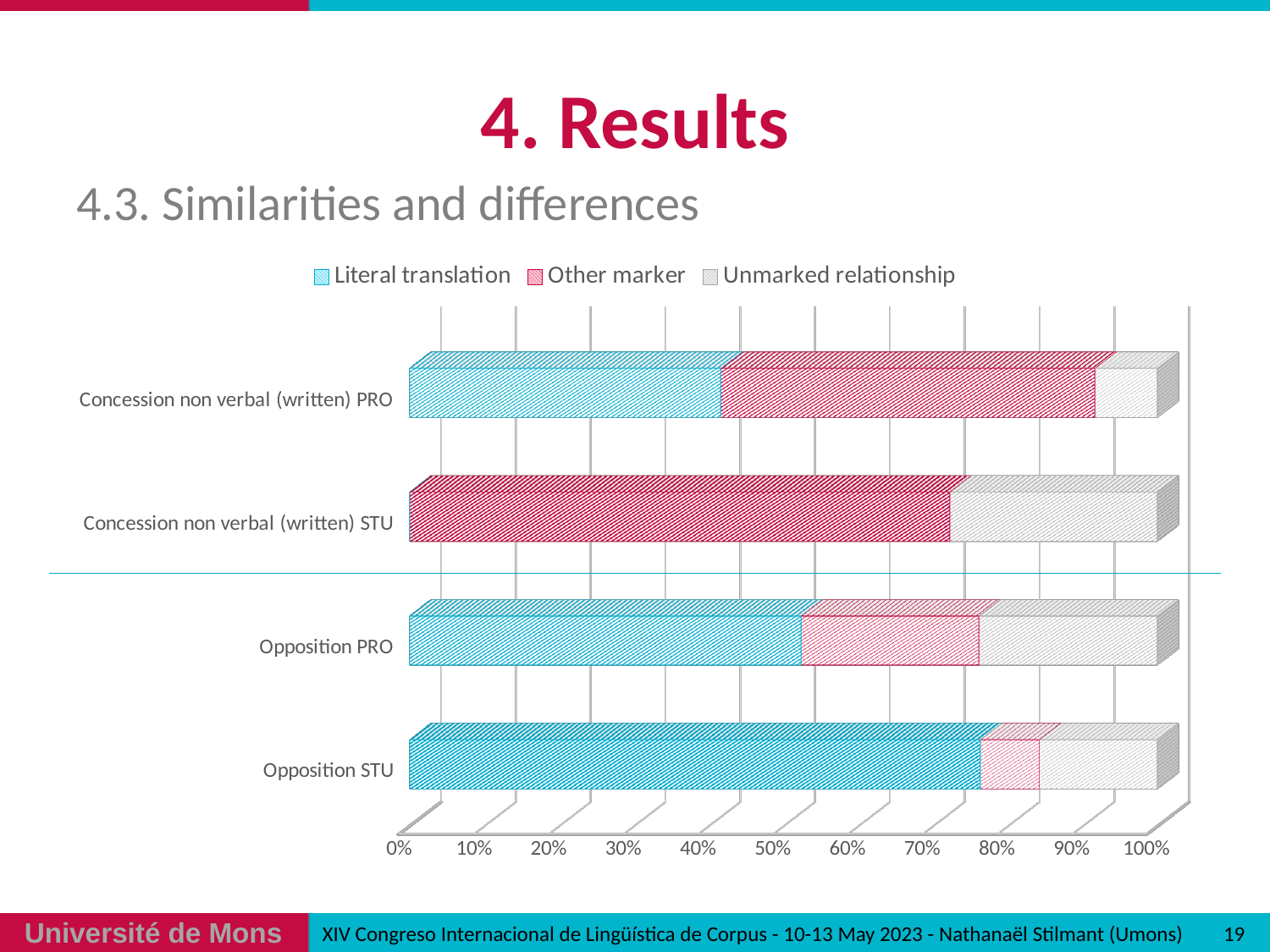
How many categories are plotted on the chart? 4 Is the Literal translation share for Concession non verbal (written) PRO greater or less than 50%? less Is the Literal translation share for Opposition STU greater or less than 70%? greater How many series does the legend list? 3 What kind of chart is shown on the slide? bar chart Which series are listed in the chart legend? Literal translation, Other marker, Unmarked relationship Which category has the largest Literal translation share? Opposition STU Is the Other marker share for Concession non verbal (written) STU greater or less than 60%? greater Which has the larger Literal translation share, Opposition STU or Concession non verbal (written) PRO? Opposition STU Which category has the smallest Literal translation share? Concession non verbal (written) STU Which category has the largest Other marker share? Concession non verbal (written) STU